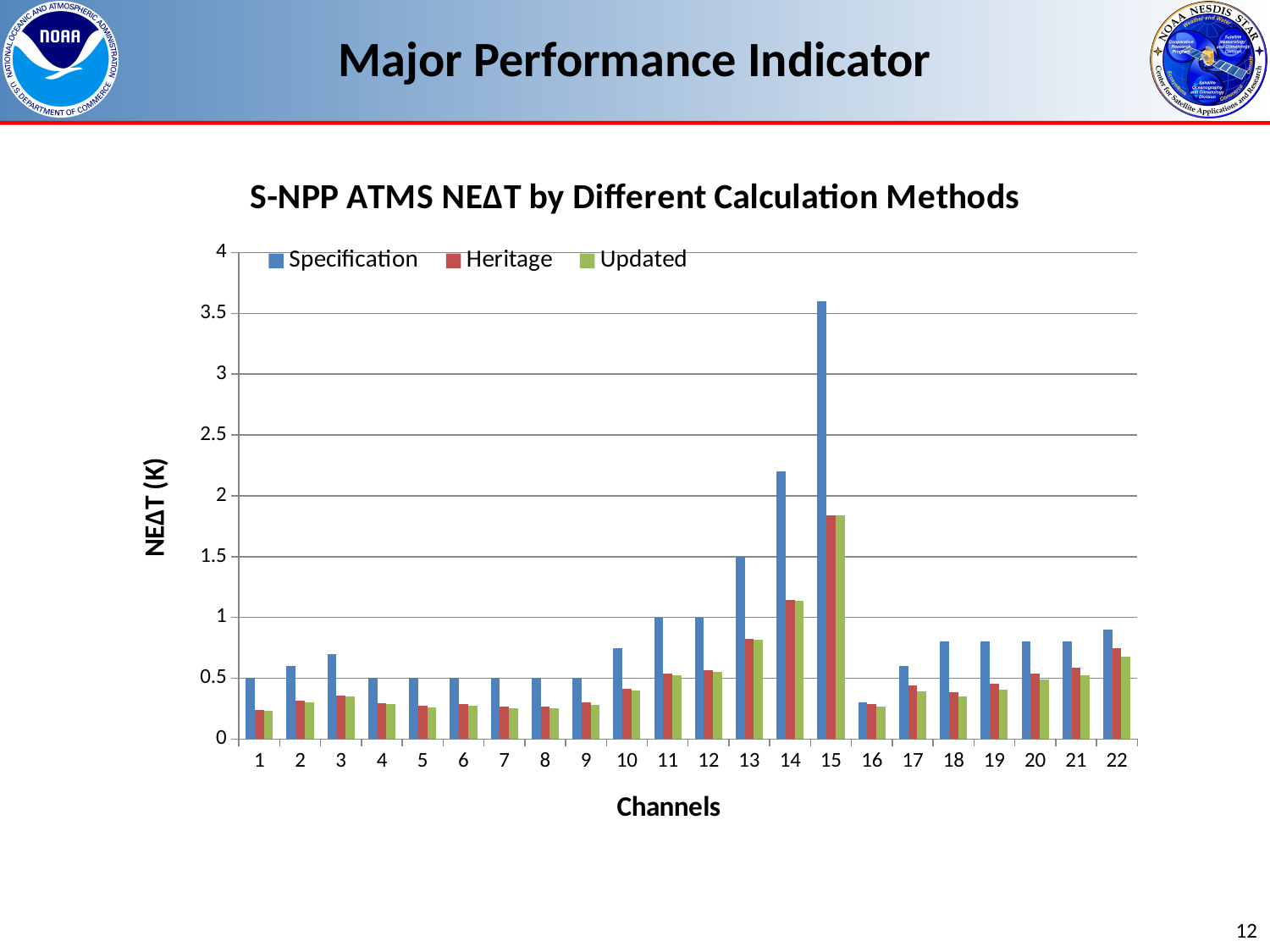
What is the label of the y axis? NEΔT (K) Which channel has the highest Specification value? 15 Which is larger for channel 14, the Specification value or the Heritage value? Specification How many series does the legend list? 3 Is the Specification value for channel 15 greater or less than 3.5? greater What is the title of the chart? S-NPP ATMS NEΔT by Different Calculation Methods How many channels are shown on the x axis? 22 What is the Specification value for channel 5? 0.5 What is the Specification value for channel 11? 1 What is the Specification value for channel 13? 1.5 Is the Heritage value for channel 14 greater or less than 1? greater What type of chart is shown on the slide? bar chart